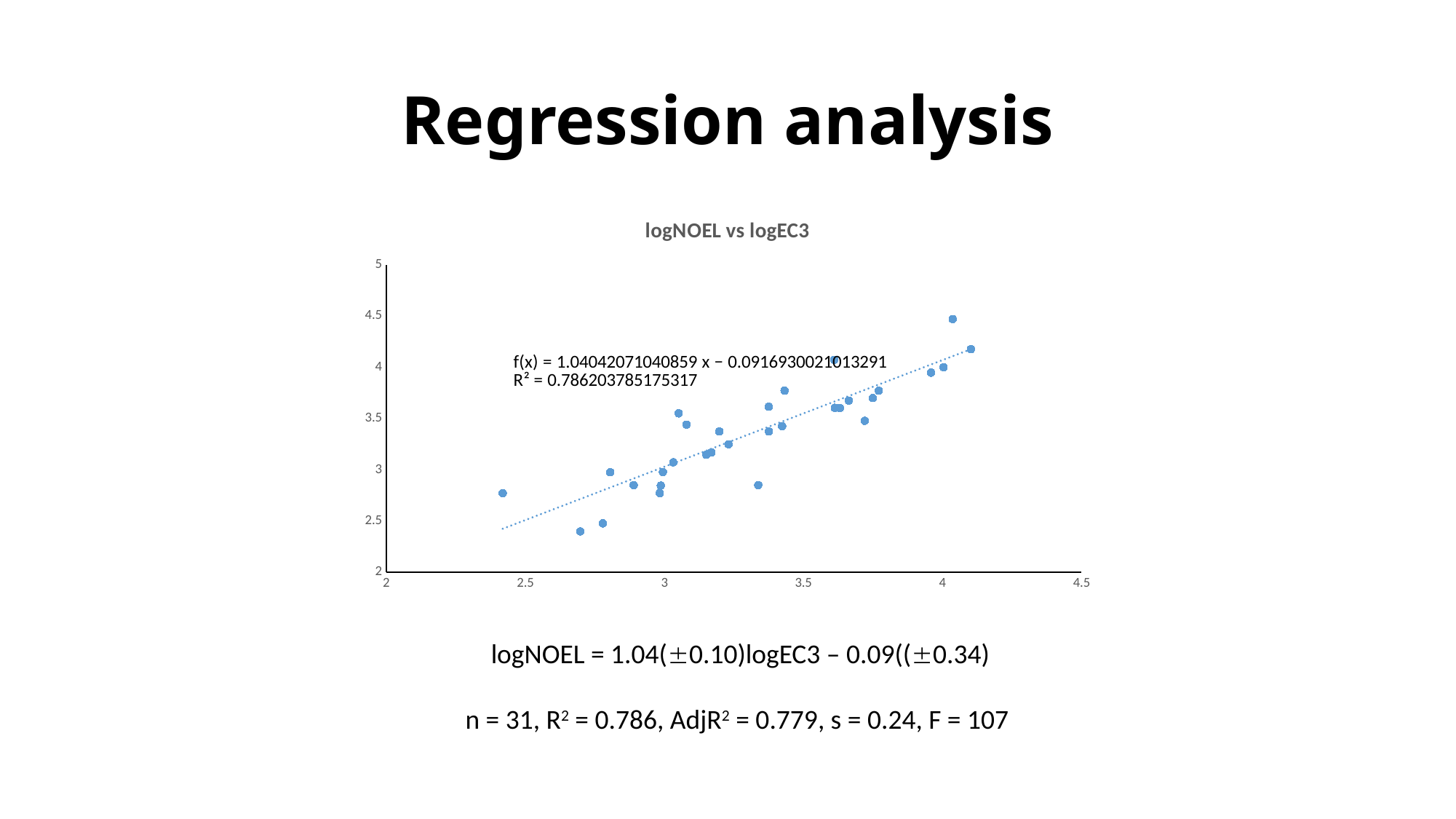
Do the plotted points generally rise or fall as the x value increases? Rise What is the maximum value shown on the x axis? 4.5 How many data points are plotted in the chart, according to the n value stated on the slide? 31 Is the y value of the lowest plotted point greater or less than 2.5? less Is the y value of the highest plotted point greater or less than 4? greater What is the slope of the trendline equation printed on the chart? 1.04042071040859 What kind of chart is shown on the slide? Scatter chart What R² value is printed on the chart next to the trendline equation? 0.786203785175317 What is the intercept in the trendline equation printed on the chart? −0.0916930021013291 What is the title of the chart? logNOEL vs logEC3 Is the x value of the leftmost plotted point greater or less than 2.5? less What is the maximum value shown on the y axis? 5